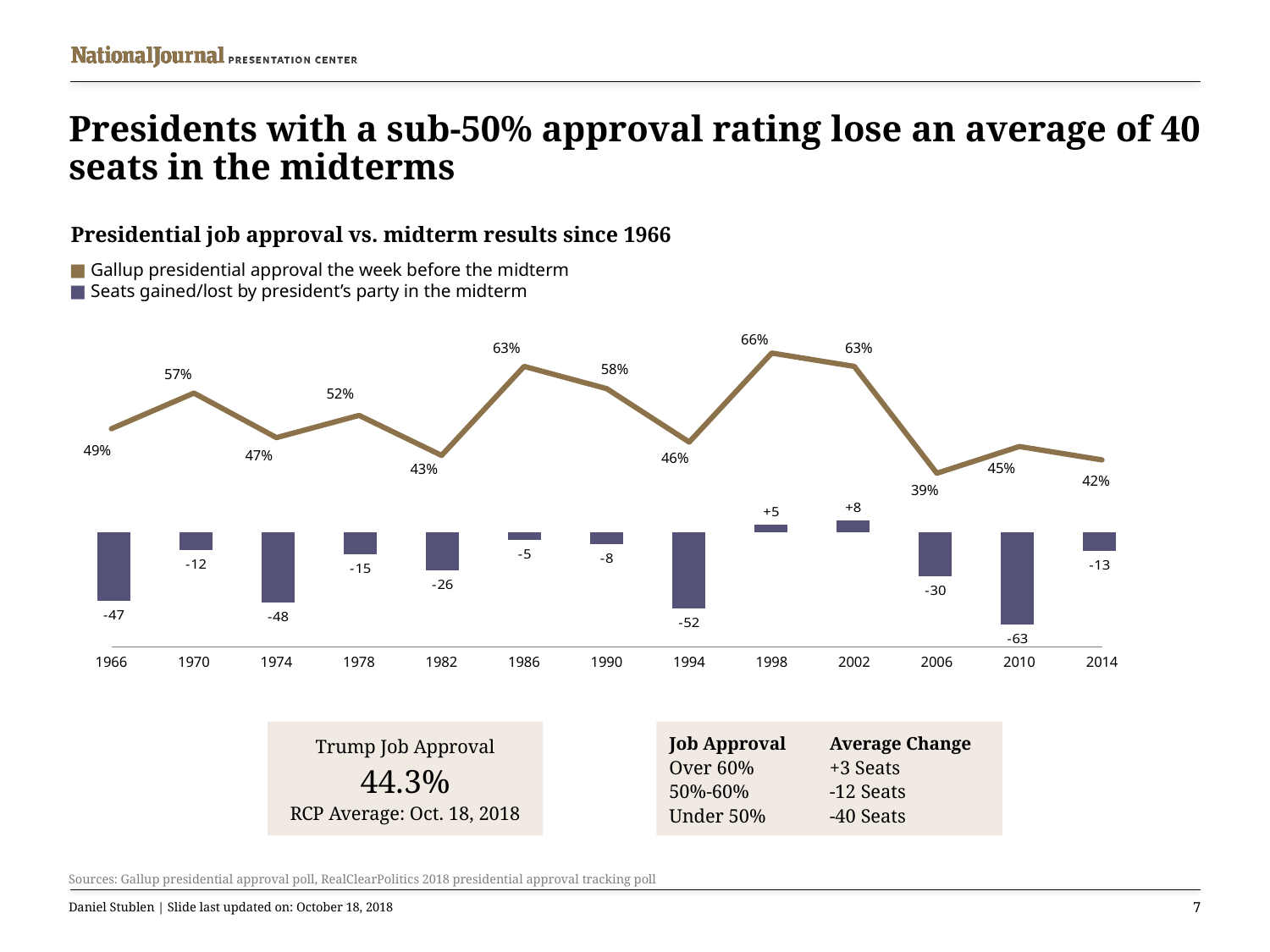
What kind of chart is used to show the seats gained/lost by the president's party? Bar chart Did the Gallup presidential approval rise or fall from 2002 to 2006? Fall What is the title of the chart? Presidential job approval vs. midterm results since 1966 In which midterm year did the president's party lose the most seats? 2010 How many seats did the president's party gain or lose in the 2010 midterm? -63 In which midterm year was the Gallup presidential approval the lowest? 2006 Which year had a higher Gallup presidential approval before the midterm, 1970 or 1990? 1990 How many midterm years are shown on the x axis of the chart? 13 How many series does the chart's legend list? 2 In which midterm year did the president's party gain the most seats? 2002 What is the difference in Gallup presidential approval between 1986 and 1982? 20 percentage points What was the Gallup presidential approval the week before the midterm in 1998? 66%